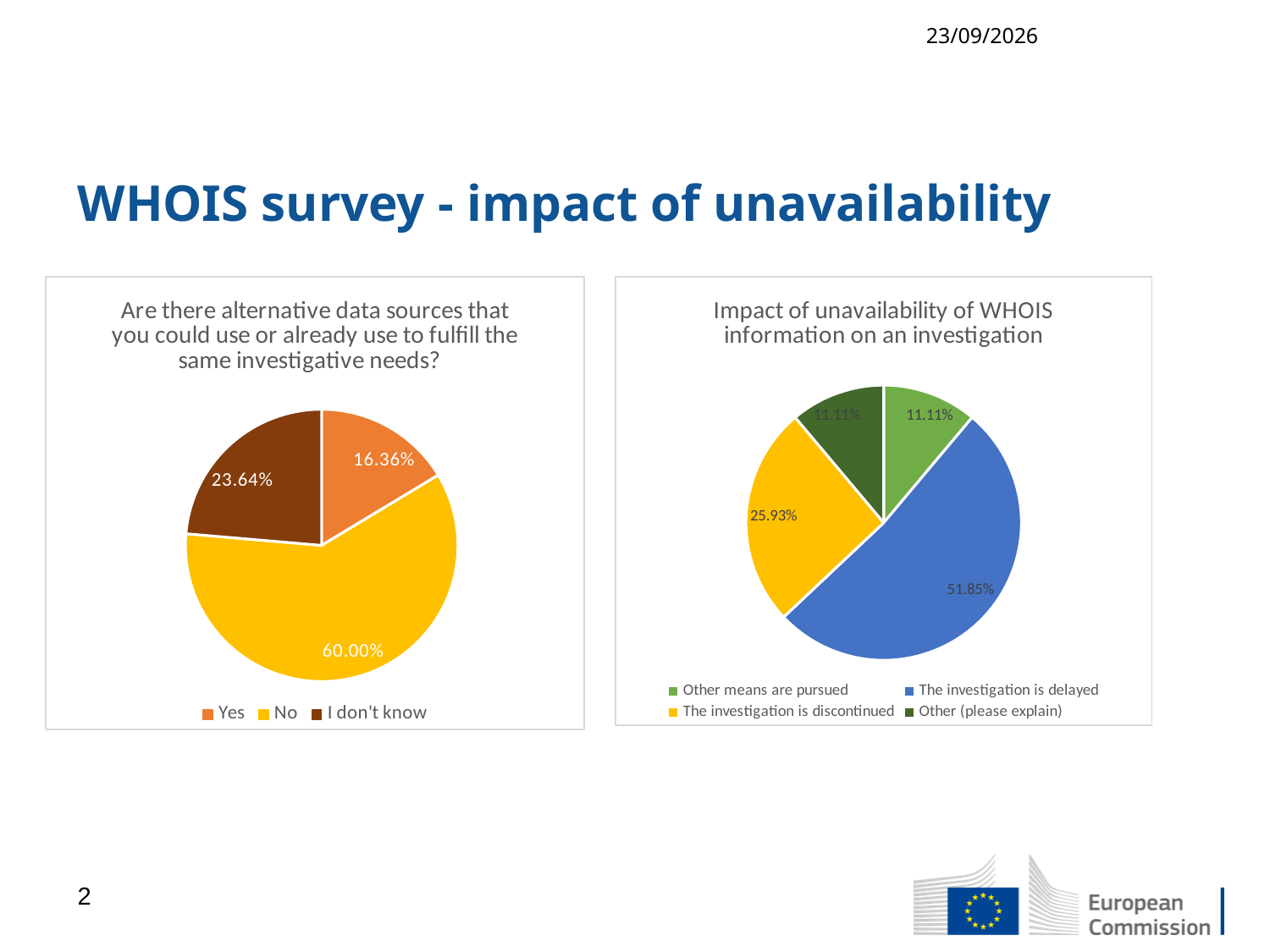
In the right chart ('Impact of unavailability of WHOIS information on an investigation'), how many categories does the legend list? 4 In the left chart ('Are there alternative data sources...'), which answer has the smallest share? Yes In the left chart ('Are there alternative data sources...'), what is the difference in percentage points between 'No' and 'I don't know'? 36.36 In the left chart ('Are there alternative data sources...'), what share of respondents answered 'No'? 60.00% In the left chart ('Are there alternative data sources...'), what share of respondents answered 'Yes'? 16.36% In the left chart ('Are there alternative data sources...'), which answer has the largest share? No In the right chart ('Impact of unavailability of WHOIS information on an investigation'), which category has the largest share? The investigation is delayed What type of chart is used on the left side of the slide? Pie chart In the left chart ('Are there alternative data sources...'), what share of respondents answered 'I don't know'? 23.64% In the right chart ('Impact of unavailability of WHOIS information on an investigation'), what share corresponds to 'Other means are pursued'? 11.11% In the right chart ('Impact of unavailability of WHOIS information on an investigation'), what share corresponds to 'The investigation is discontinued'? 25.93% In the right chart ('Impact of unavailability of WHOIS information on an investigation'), what share corresponds to 'The investigation is delayed'? 51.85%